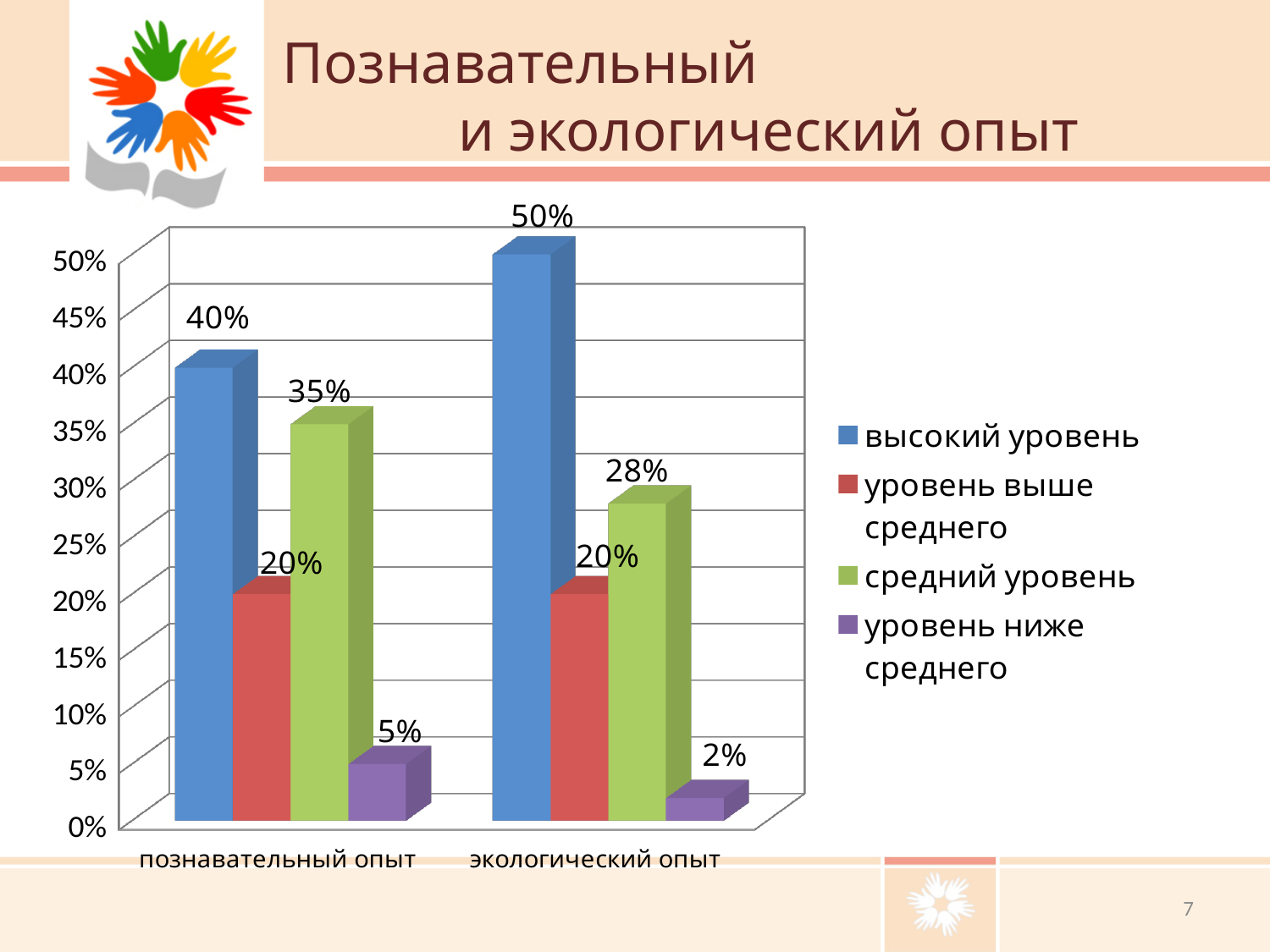
What colour represents средний уровень in the chart? green What kind of chart is shown on the slide? bar chart What is the value for уровень выше среднего in the познавательный опыт category? 20% What is the value for высокий уровень in the познавательный опыт category? 40% How many series does the legend list? 4 What is the difference between the высокий уровень values for экологический опыт and познавательный опыт? 10% Which is larger: средний уровень for познавательный опыт or средний уровень for экологический опыт? познавательный опыт How many categories are shown on the x axis? 2 What is the value for уровень ниже среднего in the экологический опыт category? 2% What is the value for средний уровень in the экологический опыт category? 28% Which series has the lowest value in the познавательный опыт category? уровень ниже среднего Which series has the highest value in the экологический опыт category? высокий уровень